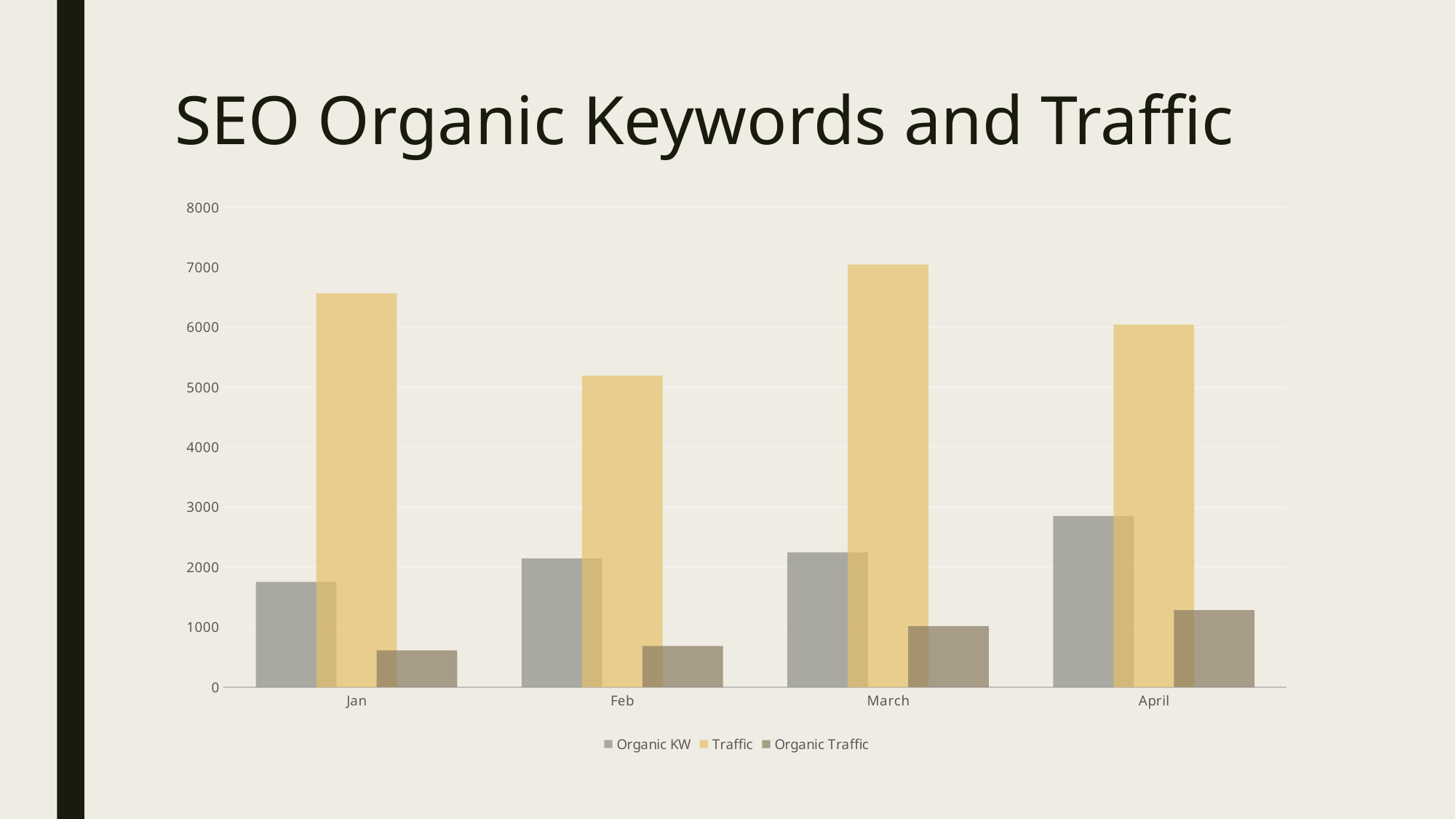
Is the Organic Traffic value for Feb greater or less than 1000? less Which is larger, Traffic in Jan or Traffic in April? Jan In which month is Traffic lowest? Feb In which month is Organic KW highest? April In which month is Organic Traffic highest? April How many series does the chart's legend list? 3 How many months are shown on the x axis of the chart? 4 Is the Traffic value for Jan greater or less than 6000? greater Does Organic Traffic rise or fall from Jan to April? rise In which month is Traffic highest? March Is the Organic KW value for April greater or less than 3000? less What kind of chart is shown on the slide? bar chart